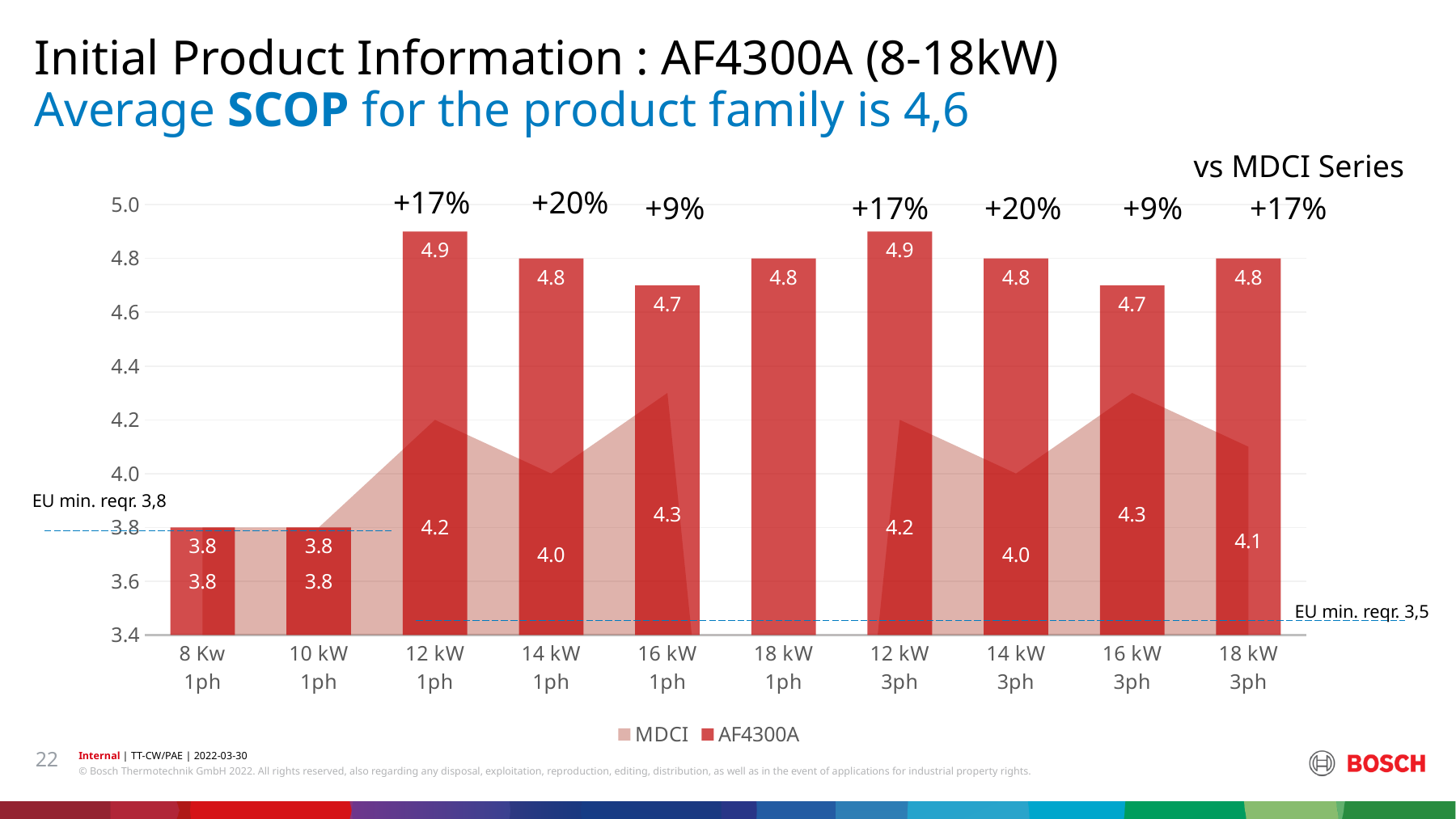
What percentage improvement is shown above the 14 kW 3ph bar? +20% Which category has the lowest AF4300A value? 8 Kw 1ph and 10 kW 1ph (both 3.8) What is the difference between the AF4300A and MDCI values for 14 kW 1ph? 0.8 What is the AF4300A value for 16 kW 1ph? 4.7 What are the two series named in the legend? MDCI and AF4300A What is the AF4300A value for 12 kW 1ph? 4.9 How many categories are shown on the x axis? 10 What is the MDCI value for 18 kW 3ph? 4.1 How many series does the legend list? 2 What is the MDCI value for 16 kW 3ph? 4.3 What kind of chart is this? Combination bar and area chart Which is larger for 12 kW 3ph, the AF4300A value or the MDCI value? AF4300A